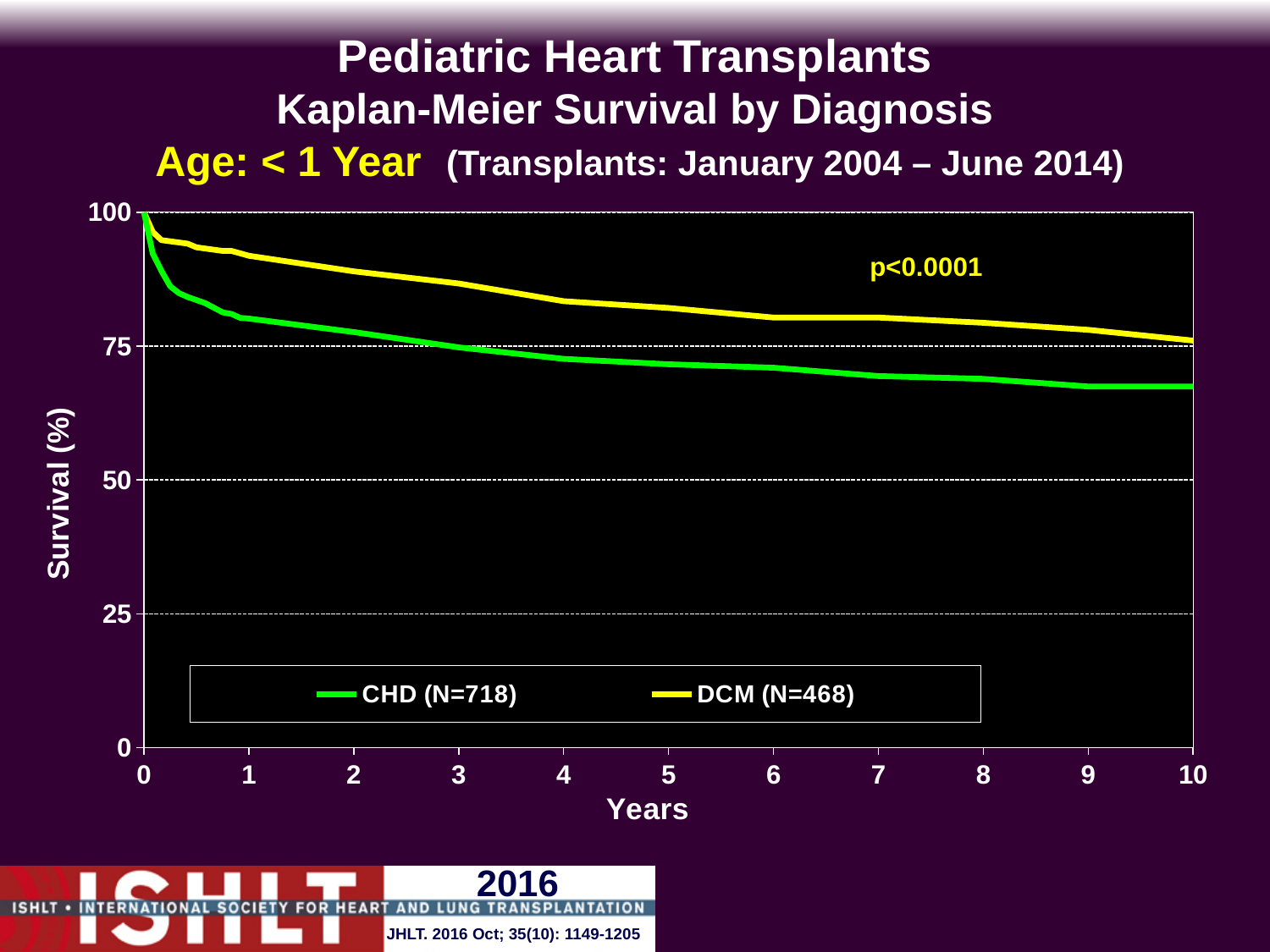
Is the survival value for CHD at 10 years greater or less than 75? less Is the survival value for DCM at 5 years greater or less than 75? greater Is the survival value for CHD at 1 year greater or less than 75? greater What is the N for the DCM group shown in the legend? 468 Do the survival curves rise or fall as years increase? fall What is the N for the CHD group shown in the legend? 718 What is the label of the y axis? Survival (%) Which diagnosis group has the higher survival curve at 5 years, CHD or DCM? DCM How many series does the legend list? 2 What kind of chart is shown on the slide? line chart What p-value is printed on the chart? p<0.0001